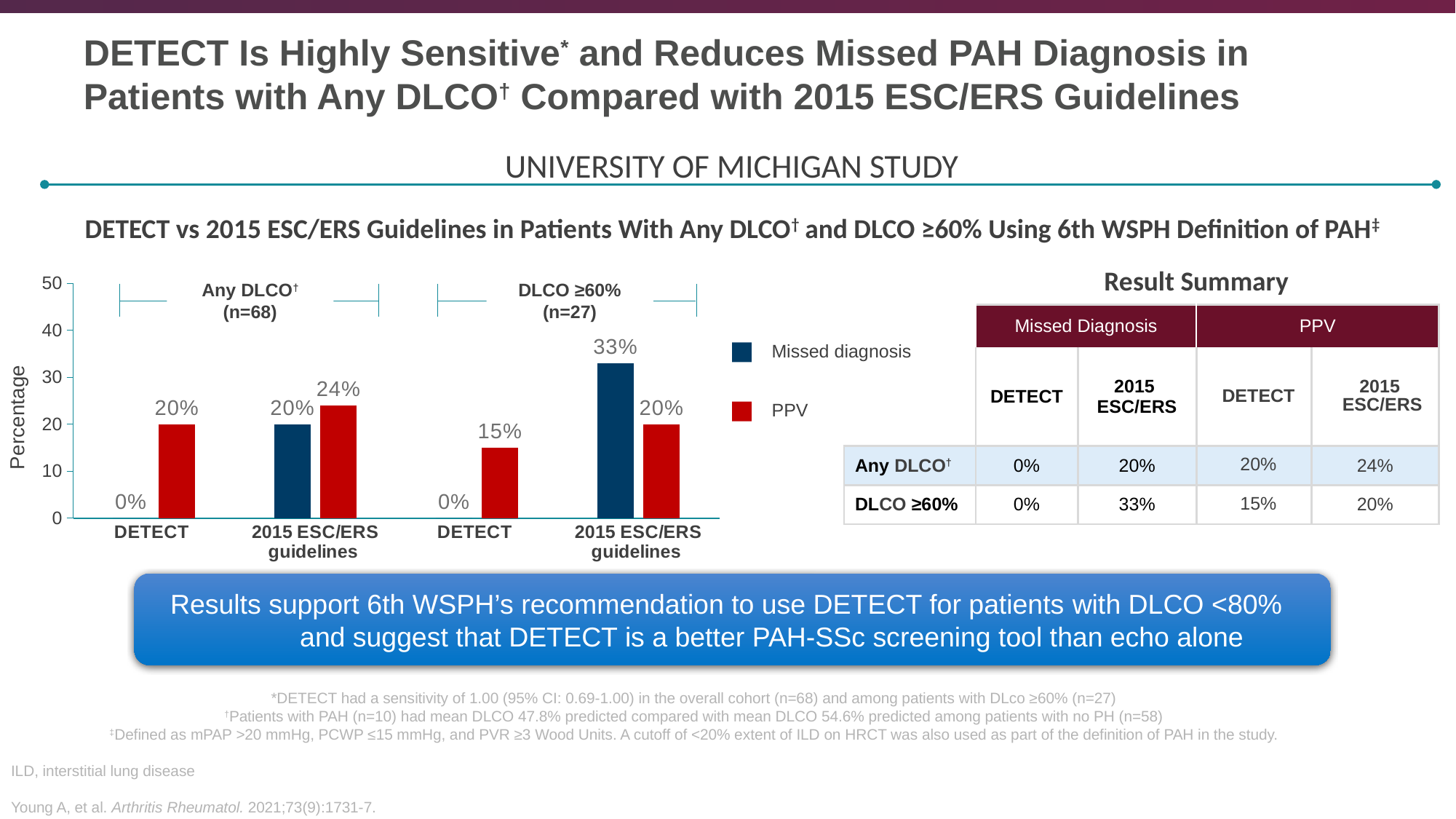
Which bar in the chart has the highest value? Missed diagnosis for 2015 ESC/ERS guidelines in the DLCO ≥60% group (33%) How many series does the chart legend list? 2 What is the PPV value for DETECT in the Any DLCO group? 20% What is the Missed diagnosis value for DETECT in the DLCO ≥60% group? 0% What type of chart is shown on the slide? Bar chart What is the PPV value for 2015 ESC/ERS guidelines in the Any DLCO group? 24% What is the Missed diagnosis value for 2015 ESC/ERS guidelines in the DLCO ≥60% group? 33% What is the difference between the PPV values for 2015 ESC/ERS guidelines and DETECT in the DLCO ≥60% group? 5% Which is larger: the PPV for DETECT in the Any DLCO group or the PPV for DETECT in the DLCO ≥60% group? Any DLCO group (20%) What is the difference between the Missed diagnosis values for 2015 ESC/ERS guidelines in the DLCO ≥60% group and the Any DLCO group? 13% What is the sample size shown for the Any DLCO group in the chart? n=68 What colour represents the PPV series in the chart? Red